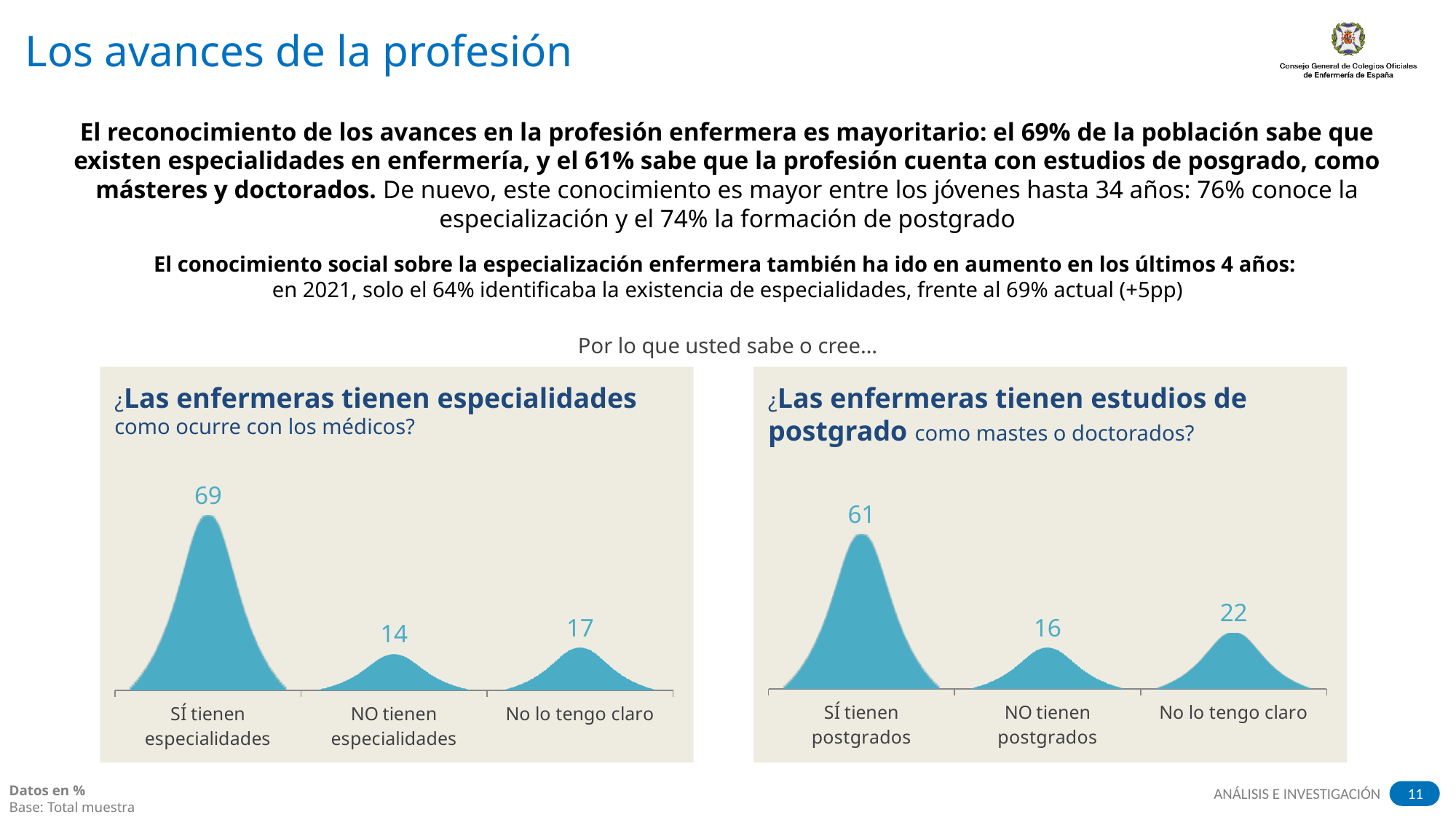
In the right chart (¿Las enfermeras tienen estudios de postgrado como mastes o doctorados?), what is the value for 'SÍ tienen postgrados'? 61 In the left chart (¿Las enfermeras tienen especialidades como ocurre con los médicos?), what is the value for 'No lo tengo claro'? 17 In the left chart (¿Las enfermeras tienen especialidades como ocurre con los médicos?), what is the value for 'NO tienen especialidades'? 14 In the left chart (¿Las enfermeras tienen especialidades como ocurre con los médicos?), which category has the highest value? SÍ tienen especialidades In the right chart (¿Las enfermeras tienen estudios de postgrado como mastes o doctorados?), what is the value for 'No lo tengo claro'? 22 In the left chart (¿Las enfermeras tienen especialidades como ocurre con los médicos?), what is the difference between 'SÍ tienen especialidades' and 'NO tienen especialidades'? 55 In the right chart (¿Las enfermeras tienen estudios de postgrado como mastes o doctorados?), which category has the lowest value? NO tienen postgrados How many charts are shown on the slide? 2 Which is larger: 'No lo tengo claro' in the left chart or 'No lo tengo claro' in the right chart? The right chart (22) In the left chart (¿Las enfermeras tienen especialidades como ocurre con los médicos?), what is the value for 'SÍ tienen especialidades'? 69 In the right chart (¿Las enfermeras tienen estudios de postgrado como mastes o doctorados?), what is the difference between 'No lo tengo claro' and 'NO tienen postgrados'? 6 How many categories does the right chart (¿Las enfermeras tienen estudios de postgrado como mastes o doctorados?) show? 3